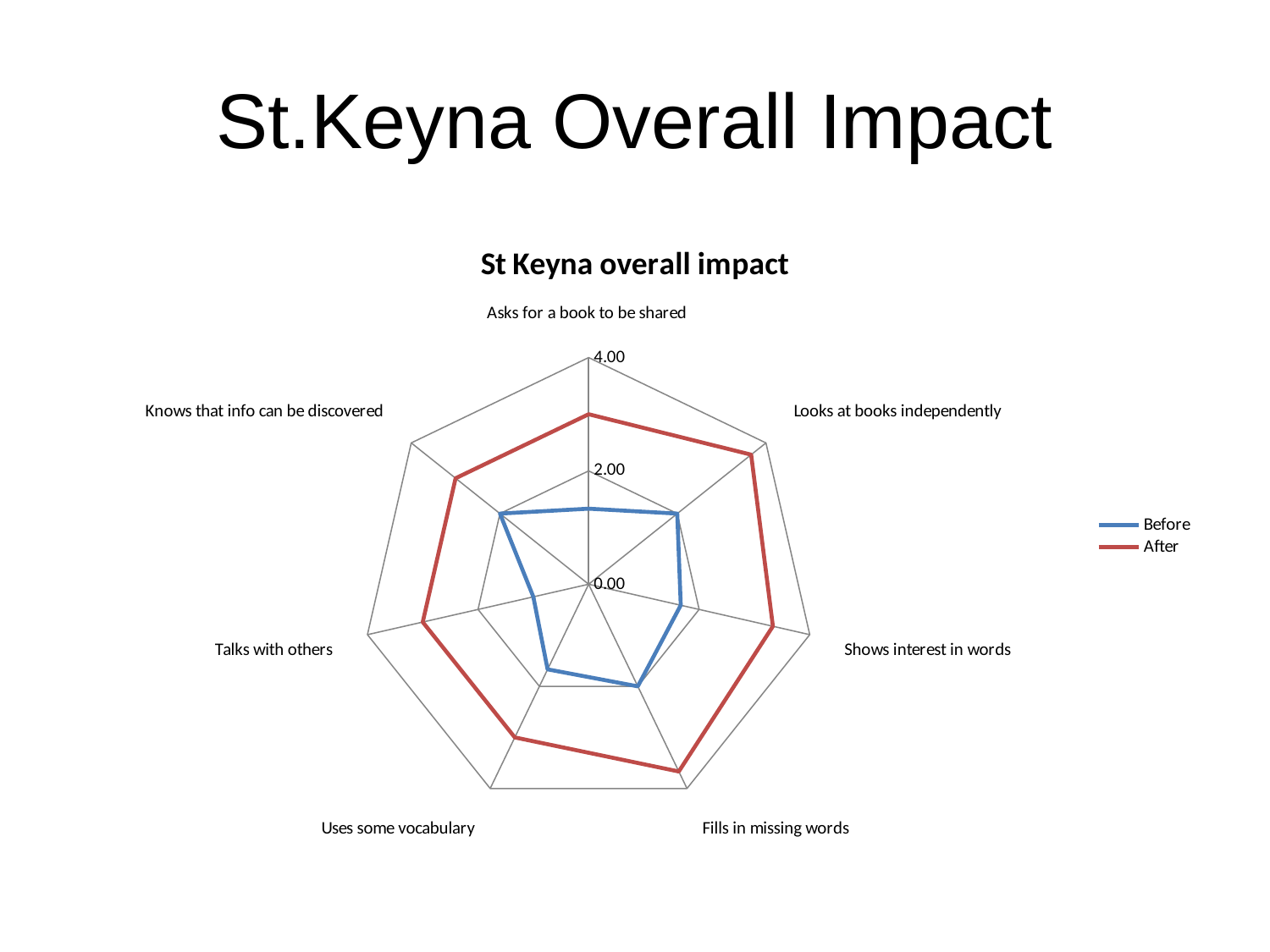
Is the After value for 'Asks for a book to be shared' greater or less than 2.00? greater Is the Before value for 'Asks for a book to be shared' greater or less than 2.00? less Is the After value for 'Looks at books independently' greater or less than 2.00? greater What kind of chart is shown on the slide? Radar chart How many categories (axes) does the radar chart have? 7 For 'Uses some vocabulary', which series has the larger value, Before or After? After What are the two series named in the legend? Before and After How many series does the legend list? 2 What is the title of the chart? St Keyna overall impact For 'Shows interest in words', which series has the larger value, Before or After? After